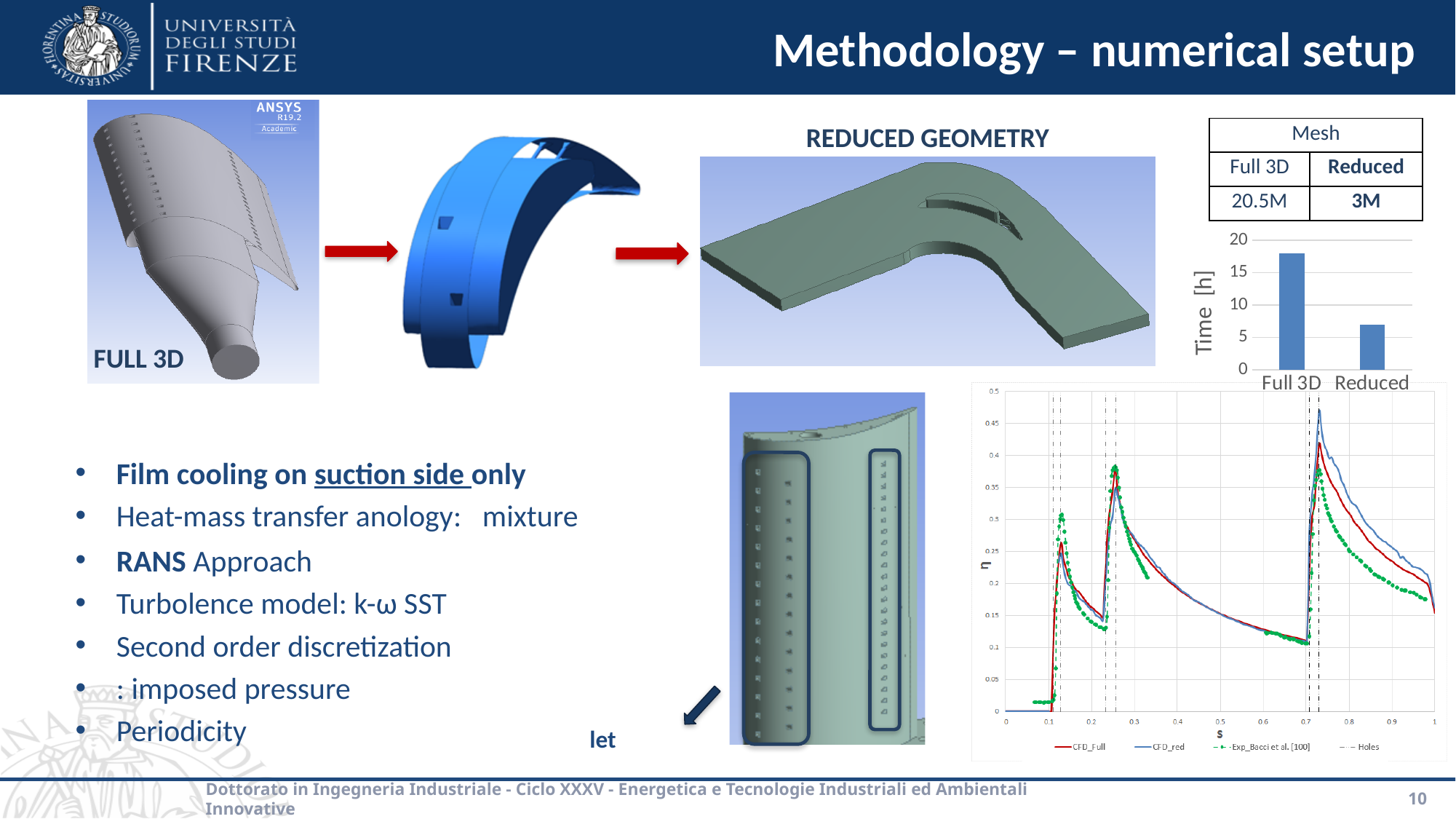
In the Time [h] bar chart, is the value for Reduced greater or less than 10? less In the η versus s line chart, which series reaches the highest peak value? CFD_red What is the y-axis label of the bar chart in the upper right of the slide? Time [h] In the Time [h] bar chart, how many categories are shown on the x axis? 2 In the Time [h] bar chart, which category has the highest value? Full 3D In the Time [h] bar chart, which is larger, the value for Full 3D or the value for Reduced? Full 3D In the Time [h] bar chart, which category has the lowest value? Reduced In the η versus s line chart, how many series does the legend list? 4 In the Time [h] bar chart, is the value for Full 3D greater or less than 15? greater What kind of chart is the chart with the y axis labelled Time [h]? bar chart What kind of chart is the chart in the lower right with η on the y axis? line chart In the η versus s line chart, is the peak value of the CFD_red series greater or less than 0.4? greater